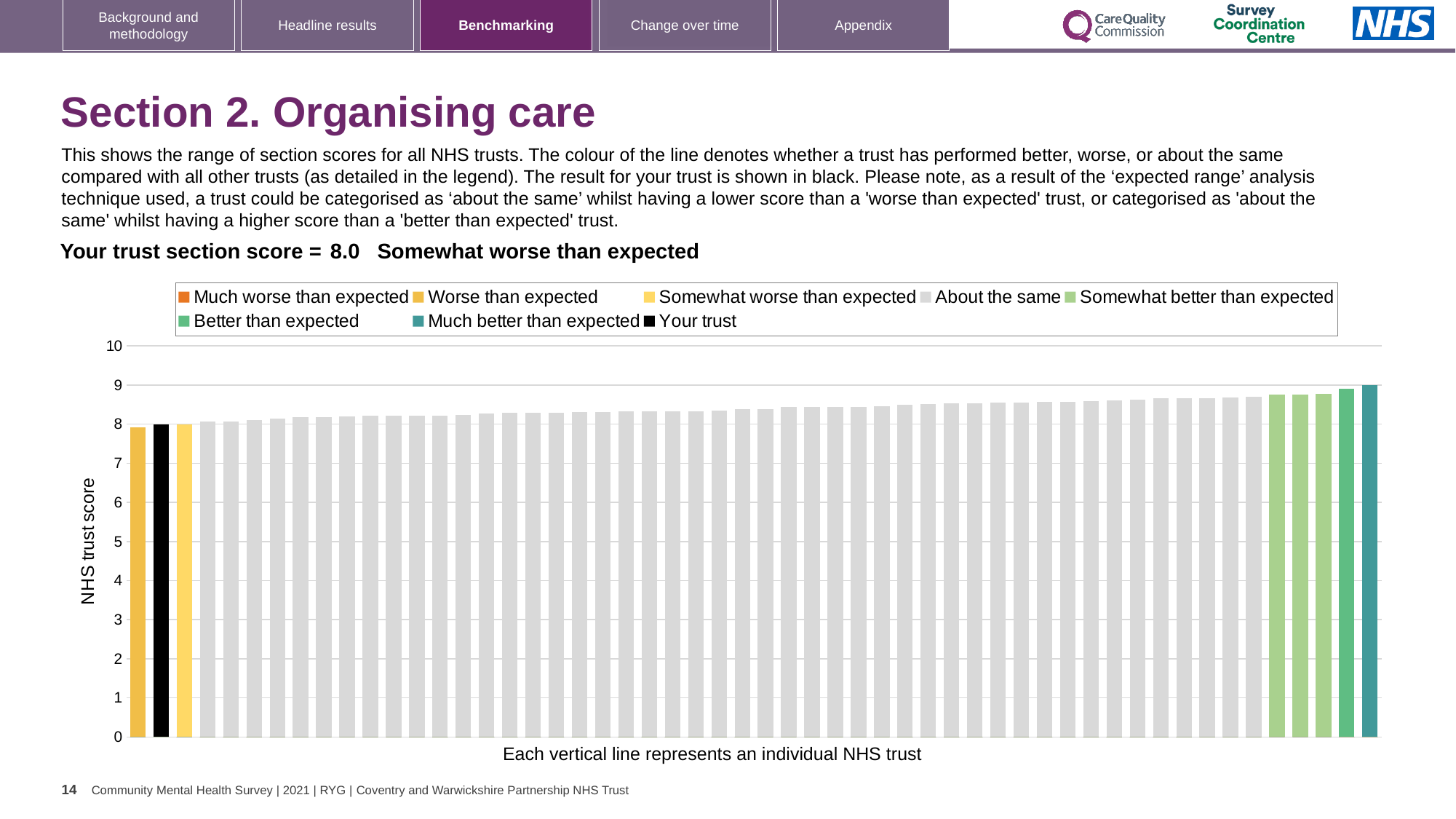
Which legend category does the tallest bar on the chart belong to? Much better than expected Is the value of the tallest bar (the rightmost bar) greater or less than 8? greater Which is larger: the value of the black 'Your trust' bar or the value of the rightmost bar? the rightmost bar What kind of chart is shown on the slide? bar chart How many entries does the chart legend list? 8 Which legend category does the shortest bar on the chart belong to? Worse than expected Is the value of the leftmost bar greater or less than 7? greater What is the trust's section score shown on the slide? 8.0 Do the bar values rise or fall from left to right along the x axis? rise What colour is used for the 'Your trust' bar in the chart? black Is the value of the black 'Your trust' bar greater or less than 9? less What is the label on the y axis of the chart? NHS trust score